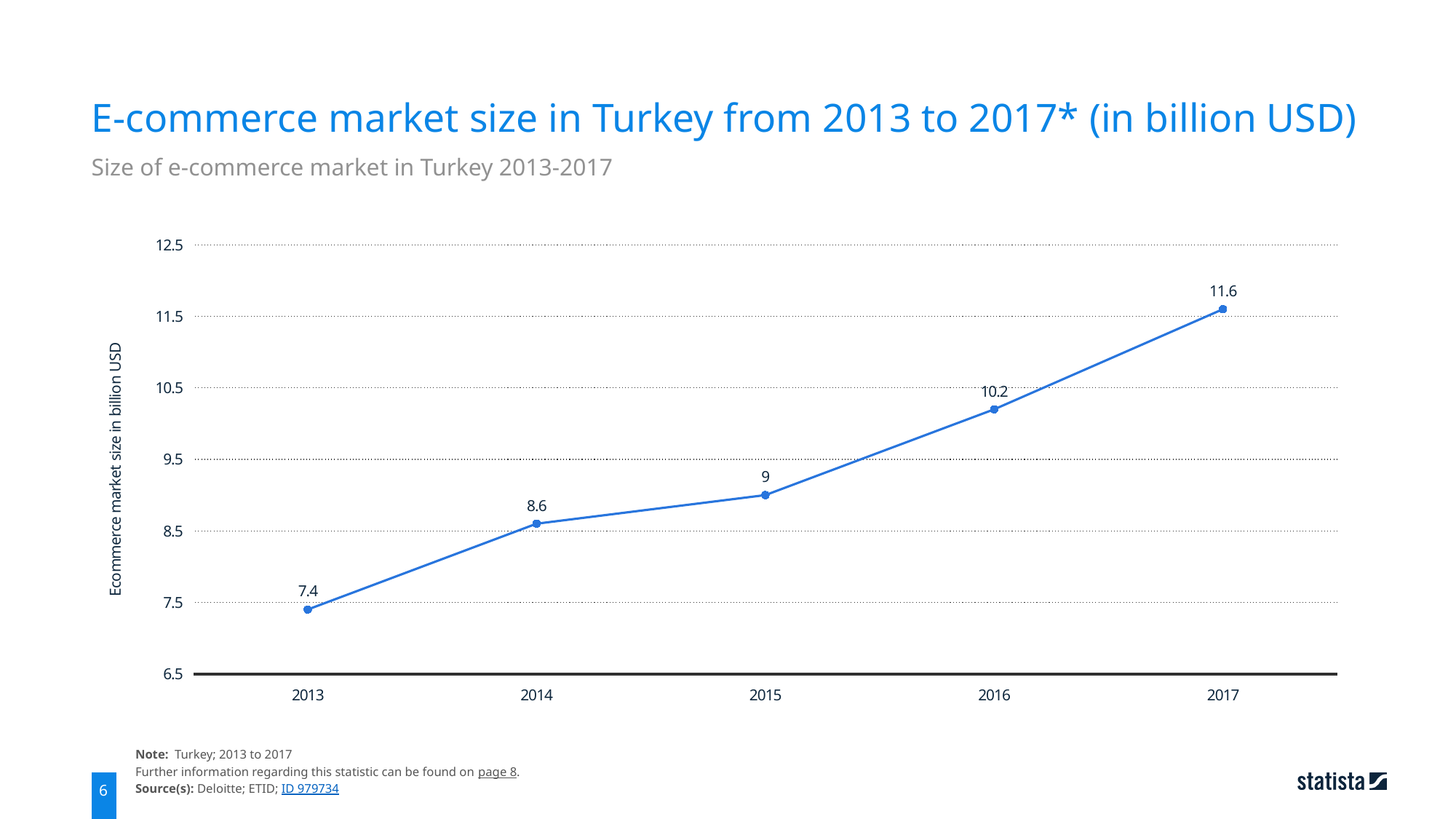
What kind of chart is shown on the slide? line chart Which year has the lowest e-commerce market size? 2013 What is the difference in e-commerce market size between 2016 and 2015? 1.2 How many years are plotted on the chart? 5 What was the e-commerce market size in Turkey in 2013? 7.4 Is the value for 2016 greater or less than 9.5? greater What is the difference in e-commerce market size between 2017 and 2013? 4.2 Which year has the highest e-commerce market size? 2017 Which year had a larger e-commerce market size, 2014 or 2016? 2016 Does the e-commerce market size rise or fall from 2013 to 2017? rise What was the e-commerce market size in Turkey in 2015? 9 What was the e-commerce market size in Turkey in 2017? 11.6